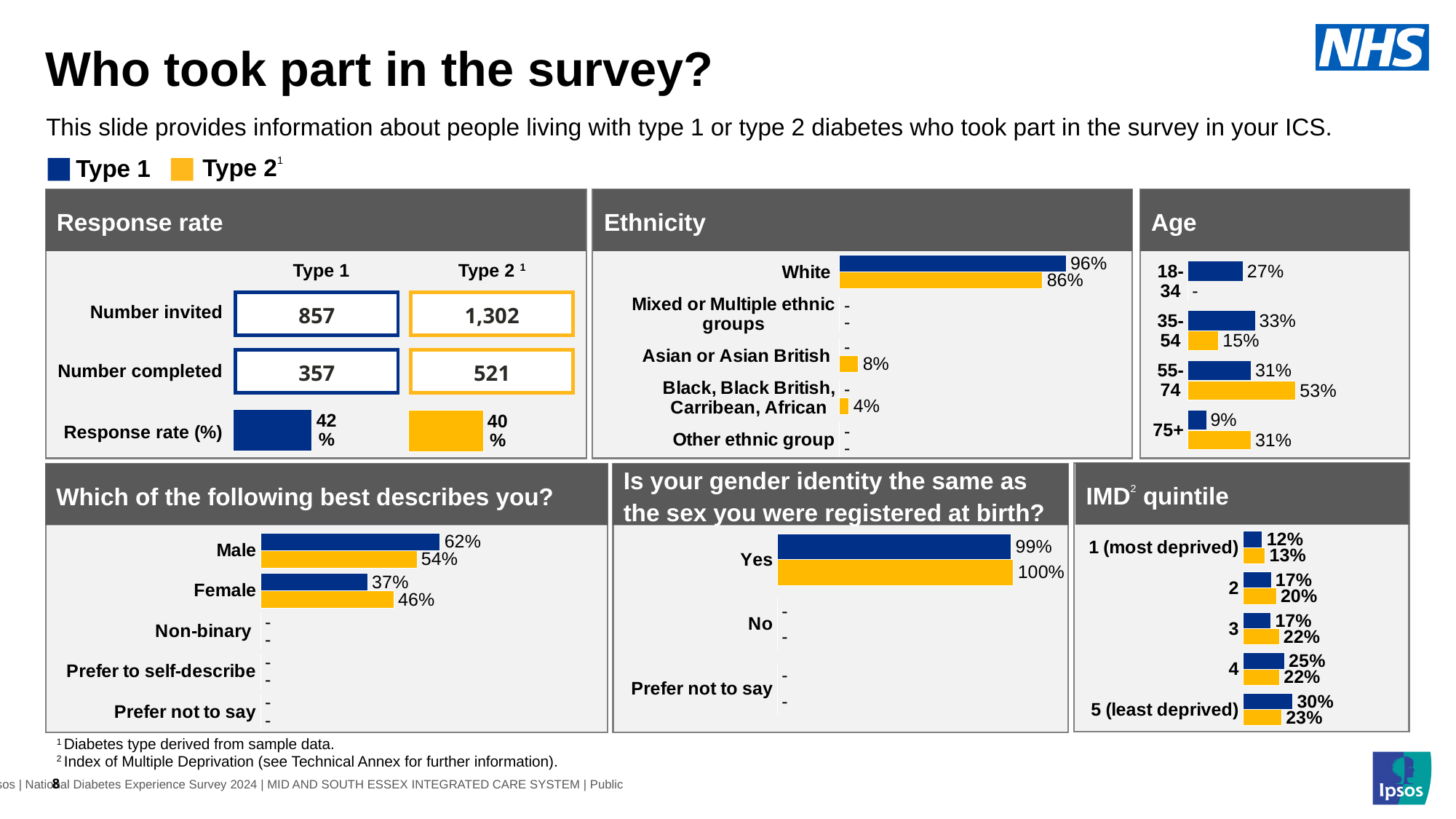
In the Age chart, which age group has the highest Type 1 value? 35-54 In the Response rate chart, what is the response rate for Type 1? 42% In the IMD quintile chart, is the Type 1 value for quintile 4 larger or smaller than the Type 2 value for quintile 4? larger In the 'Which of the following best describes you?' chart, what is the Type 2 value for Female? 46% In the 'Which of the following best describes you?' chart, what is the difference between the Type 1 and Type 2 values for Male? 8% In the Ethnicity chart, what is the Type 1 value for White? 96% In the Age chart, what is the difference between the Type 2 and Type 1 values for 75+? 22% In the gender identity chart, what is the Type 2 value for Yes? 100% In the Age chart, what is the Type 2 value for 55-74? 53% In the Ethnicity chart, what is the Type 2 value for Asian or Asian British? 8% How many series does the legend at the top of the slide list? 2 In the IMD quintile chart, which quintile has the highest Type 1 value? 5 (least deprived)